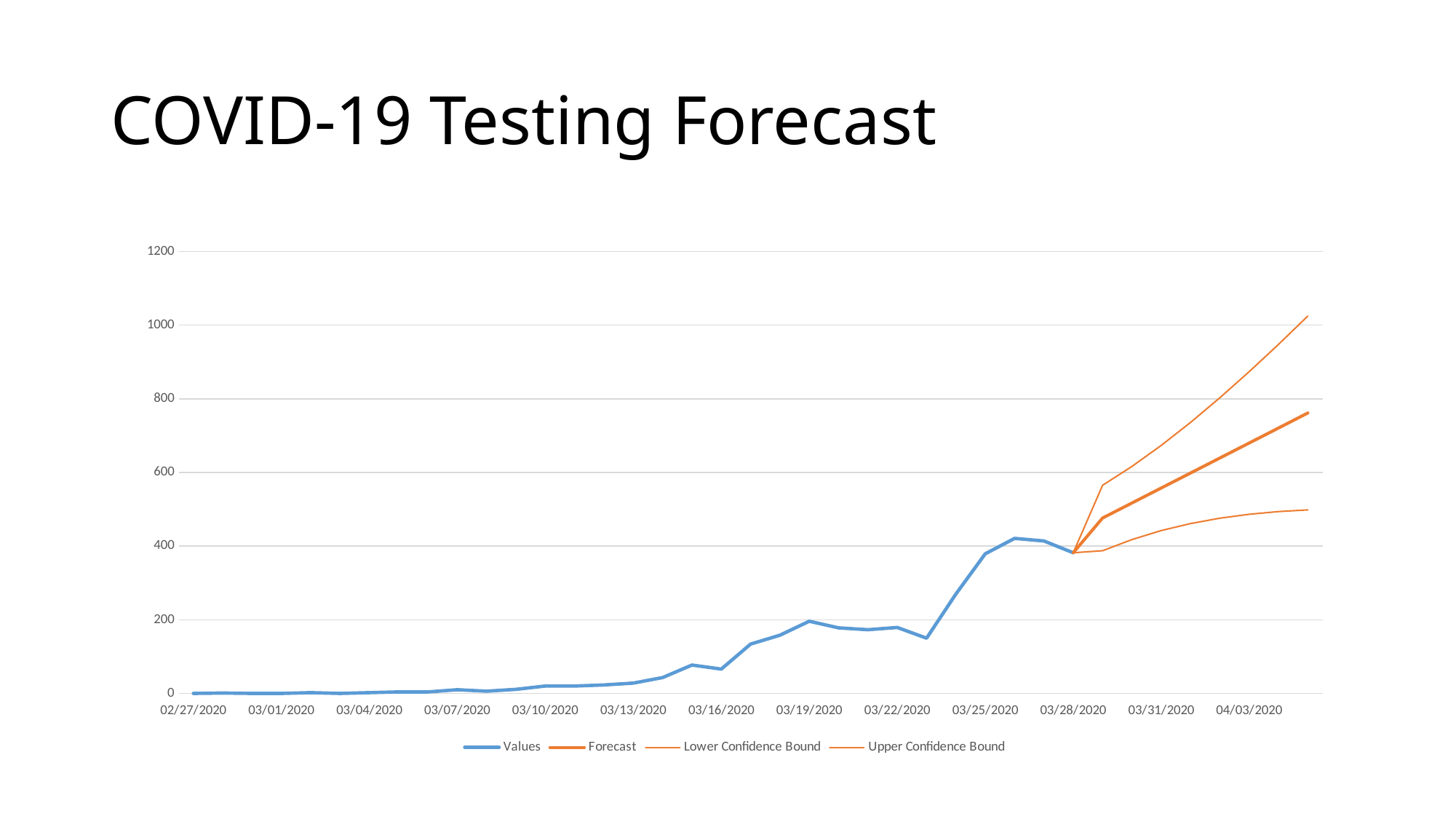
Is the value for Values on 03/25/2020 greater or less than 200? greater Is the Forecast at the last date on the chart greater or less than 600? greater Which series is drawn in blue? Values Do the Values generally rise or fall from 02/27/2020 to 03/28/2020? rise What is the title of the slide? COVID-19 Testing Forecast At the last date on the chart, which is higher, the Upper Confidence Bound or the Lower Confidence Bound? Upper Confidence Bound What kind of chart is shown on the slide? line chart Is the value for Values on 02/27/2020 greater or less than 200? less How many series does the legend list? 4